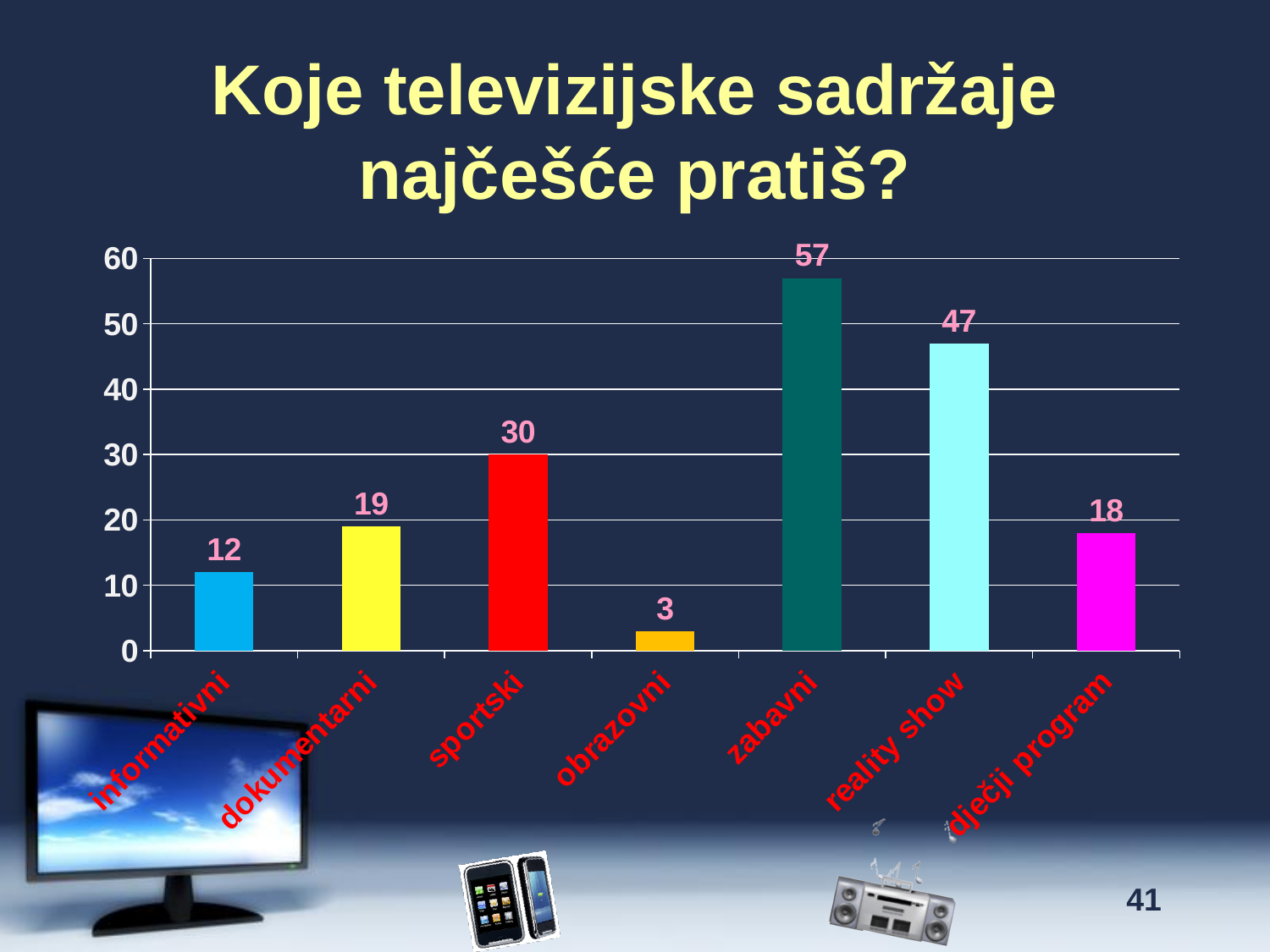
Which category has the lowest value? obrazovni Which category has the highest value? zabavni What is the title of the slide? Koje televizijske sadržaje najčešće pratiš? How many categories are shown on the x axis? 7 What is the difference between the values for zabavni and reality show? 10 What is the value for zabavni? 57 What is the value for reality show? 47 What is the value for dokumentarni? 19 What kind of chart is shown on the slide? bar chart Which is larger, the value for dokumentarni or the value for dječji program? dokumentarni What is the value for obrazovni? 3 What is the difference between the values for sportski and informativni? 18